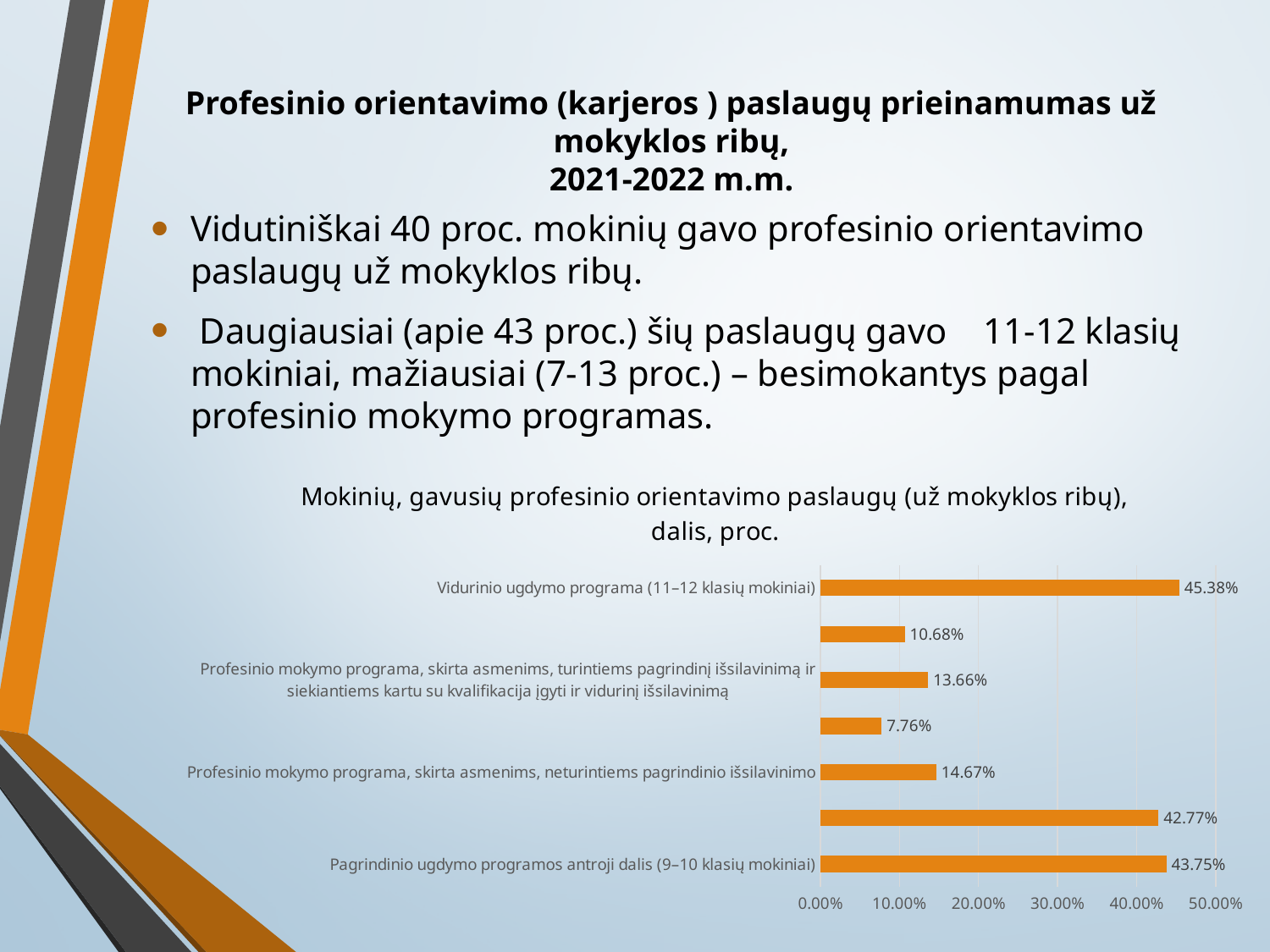
What is the title of the chart? Mokinių, gavusių profesinio orientavimo paslaugų (už mokyklos ribų), dalis, proc. What is the value for Pagrindinio ugdymo programos antroji dalis (9–10 klasių mokiniai)? 43.75% What type of chart is shown on the slide? bar chart Is the value for Vidurinio ugdymo programa (11–12 klasių mokiniai) greater or less than 40.00%? greater Which is larger: the value for Profesinio mokymo programa, skirta asmenims, neturintiems pagrindinio išsilavinimo or the value for Profesinio mokymo programa, skirta asmenims, turintiems pagrindinį išsilavinimą ir siekiantiems kartu su kvalifikacija įgyti ir vidurinį išsilavinimą? Profesinio mokymo programa, skirta asmenims, neturintiems pagrindinio išsilavinimo Which category has the highest value in the chart? Vidurinio ugdymo programa (11–12 klasių mokiniai) What is the lowest value shown in the chart? 7.76% What is the value for Profesinio mokymo programa, skirta asmenims, neturintiems pagrindinio išsilavinimo? 14.67% What is the difference between the values for Vidurinio ugdymo programa (11–12 klasių mokiniai) and Pagrindinio ugdymo programos antroji dalis (9–10 klasių mokiniai)? 1.63% What is the value for Vidurinio ugdymo programa (11–12 klasių mokiniai)? 45.38% How many bars are plotted in the chart? 7 What is the value for Profesinio mokymo programa, skirta asmenims, turintiems pagrindinį išsilavinimą ir siekiantiems kartu su kvalifikacija įgyti ir vidurinį išsilavinimą? 13.66%